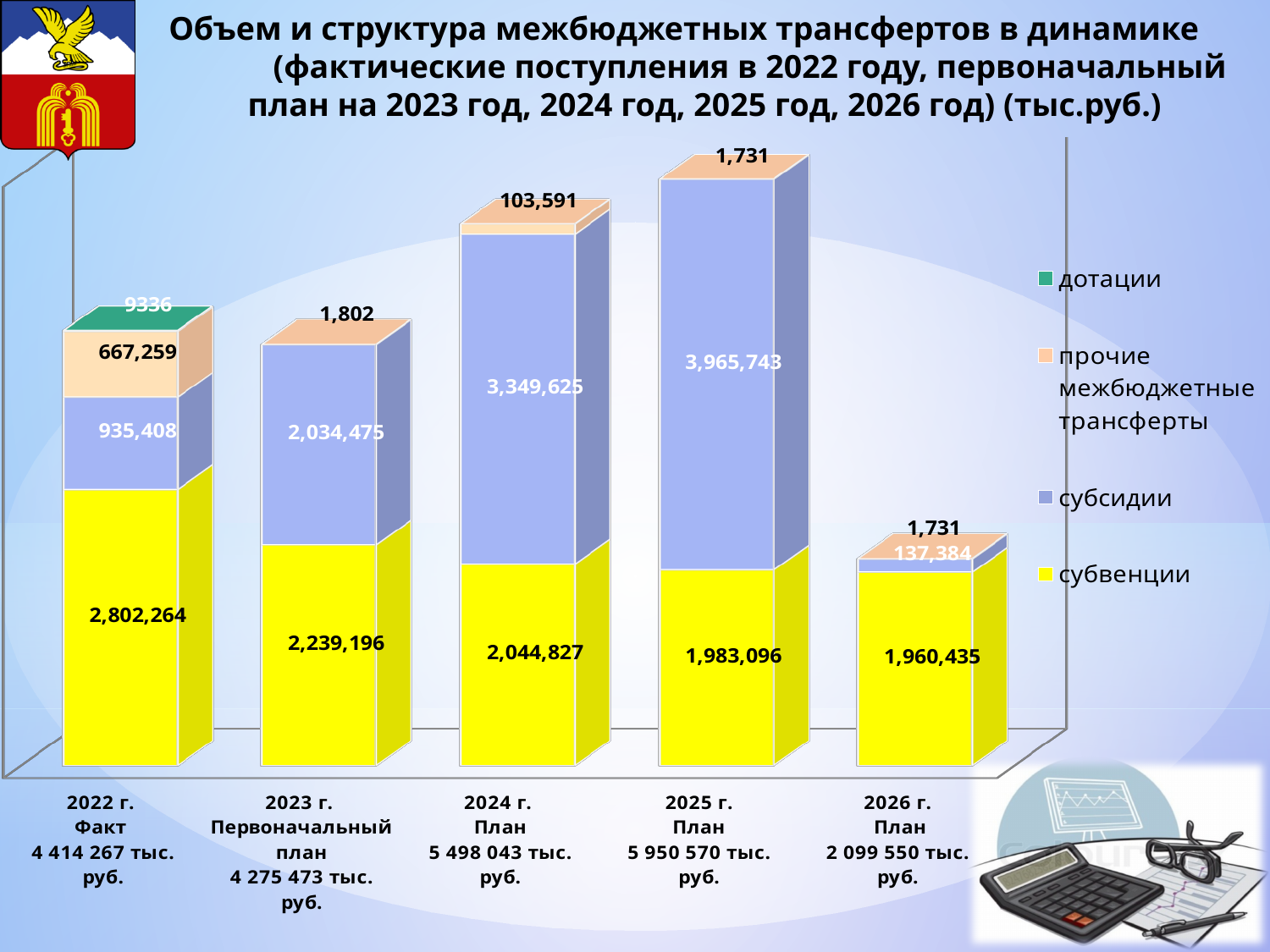
What is the difference between субсидии in 2024 г. and субсидии in 2023 г.? 1,315,150 What is the value of субсидии for 2025 г. План? 3,965,743 What is the value of субвенции for 2022 г. Факт? 2,802,264 Which year has the highest value of субсидии? 2025 г. План What is the value of прочие межбюджетные трансферты for 2024 г. План? 103,591 What is the value of дотации for 2022 г. Факт? 9336 How many year categories are shown on the x axis? 5 Which is larger in 2023 г.: субвенции or субсидии? субвенции Which year has the lowest value of субвенции? 2026 г. План How many series does the legend list? 4 What type of chart is shown on the slide? stacked bar chart What is the total of the stacked bar for 2026 г. План? 2 099 550 тыс. руб.